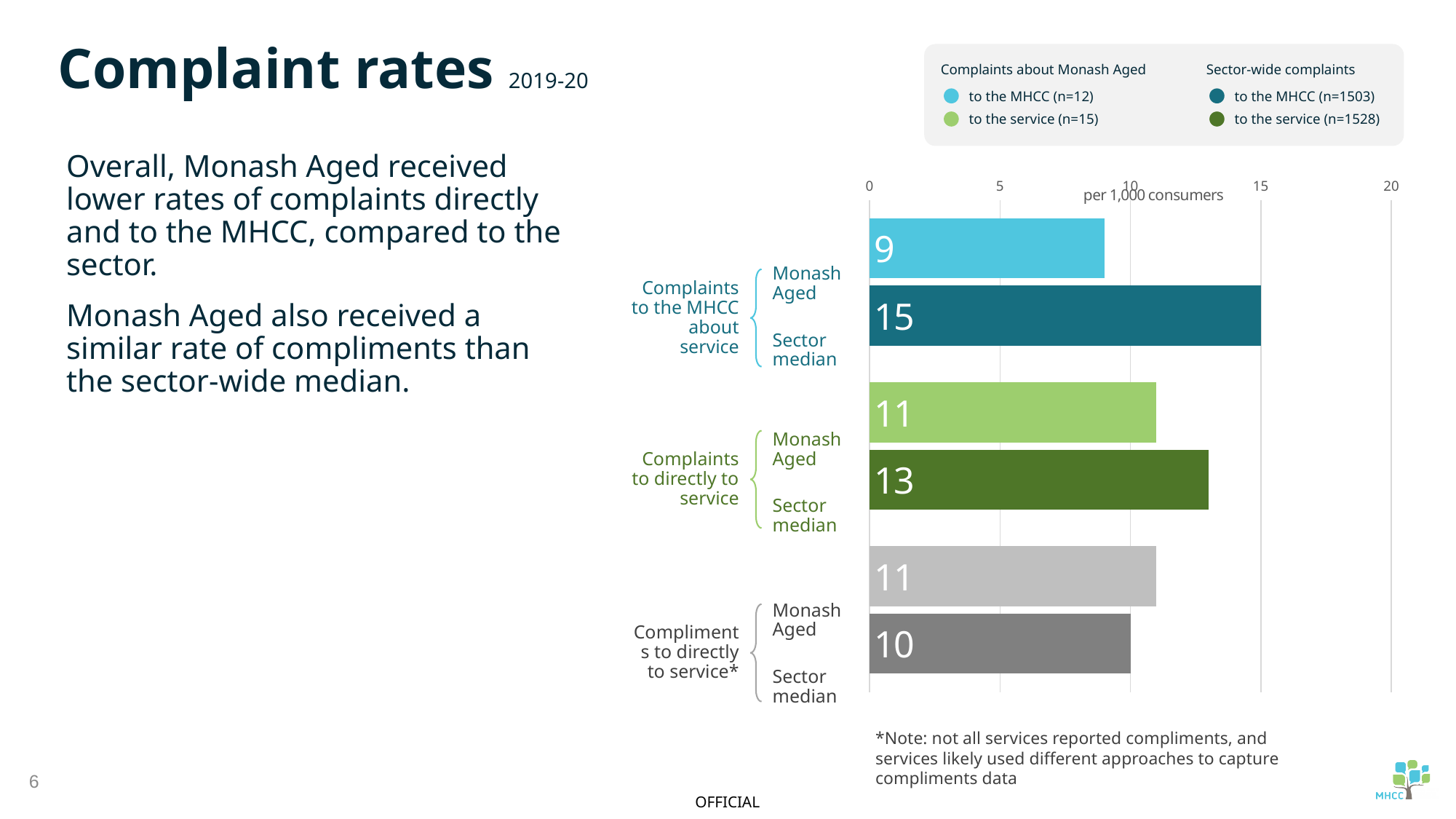
What is the sector median rate of complaints made directly to service? 13 Which bar in the chart has the highest value? Sector median, complaints to the MHCC about service What is the sector median rate of compliments made directly to service? 10 What is the rate of complaints made directly to service for Monash Aged? 11 What unit does the chart's axis label say the values are measured in? per 1,000 consumers Which bar in the chart has the lowest value? Monash Aged, complaints to the MHCC about service What is the difference between the sector median and Monash Aged for complaints to the MHCC about service? 6 What is the rate of complaints to the MHCC about service for Monash Aged, per 1,000 consumers? 9 What type of chart is shown on the slide? Bar chart What is the sector median rate of complaints to the MHCC about service? 15 For complaints made directly to service, which is larger: Monash Aged or the sector median? Sector median How many bars are plotted in the chart? 6